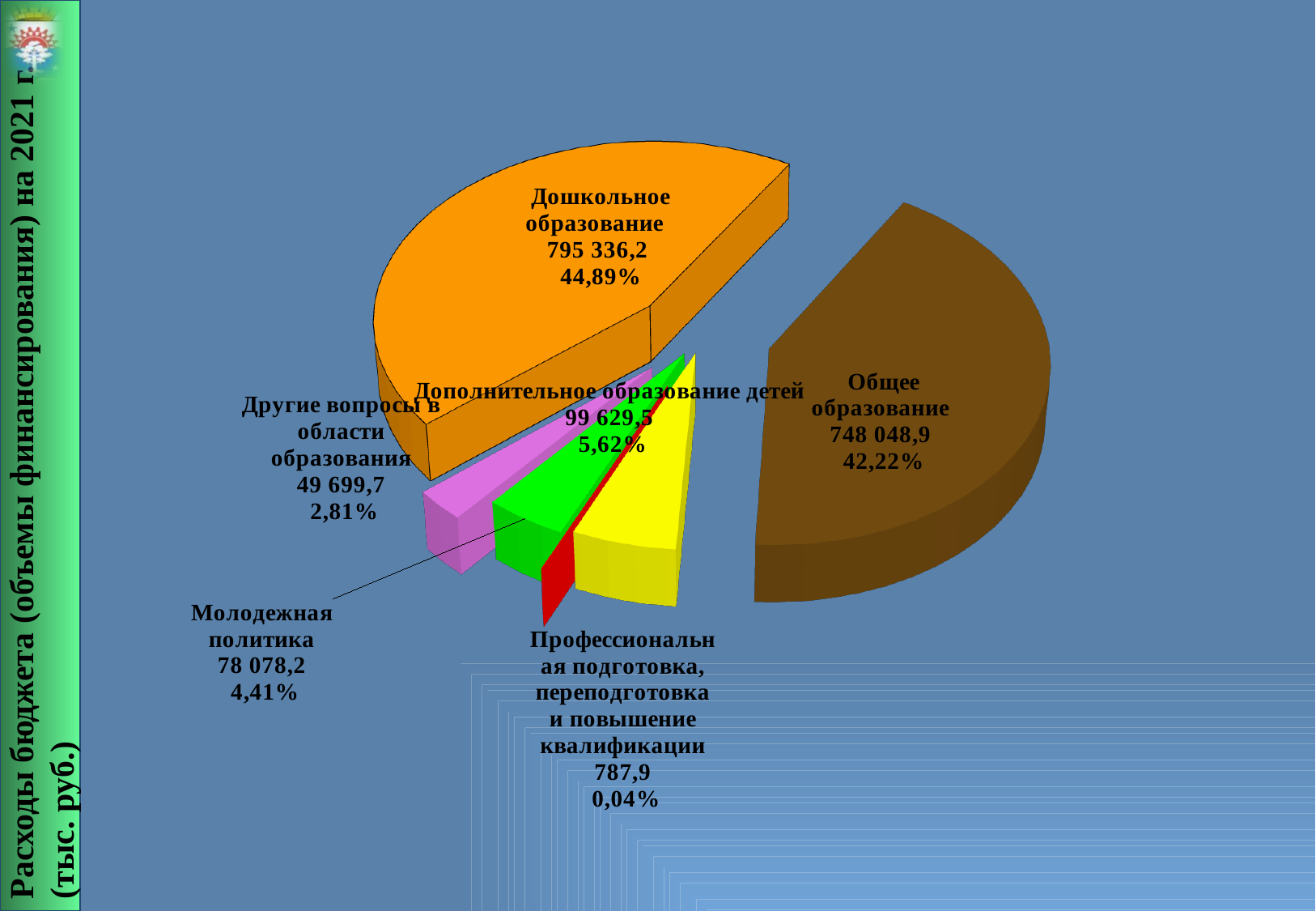
What is the difference between the values for Дошкольное образование and Общее образование? 47 287,3 Which category has the largest slice? Дошкольное образование What is the value for Молодежная политика? 78 078,2 What share of the pie does Дополнительное образование детей take? 5,62% What is the value for Профессиональная подготовка, переподготовка и повышение квалификации? 787,9 Which is larger, the value for Дополнительное образование детей or Молодежная политика? Дополнительное образование детей What kind of chart is shown on the slide? Pie chart Which category has the smallest slice? Профессиональная подготовка, переподготовка и повышение квалификации What share of the pie does Другие вопросы в области образования take? 2,81% What is the value for Общее образование? 748 048,9 How many slices does the pie chart have? 6 What is the value for Дошкольное образование? 795 336,2